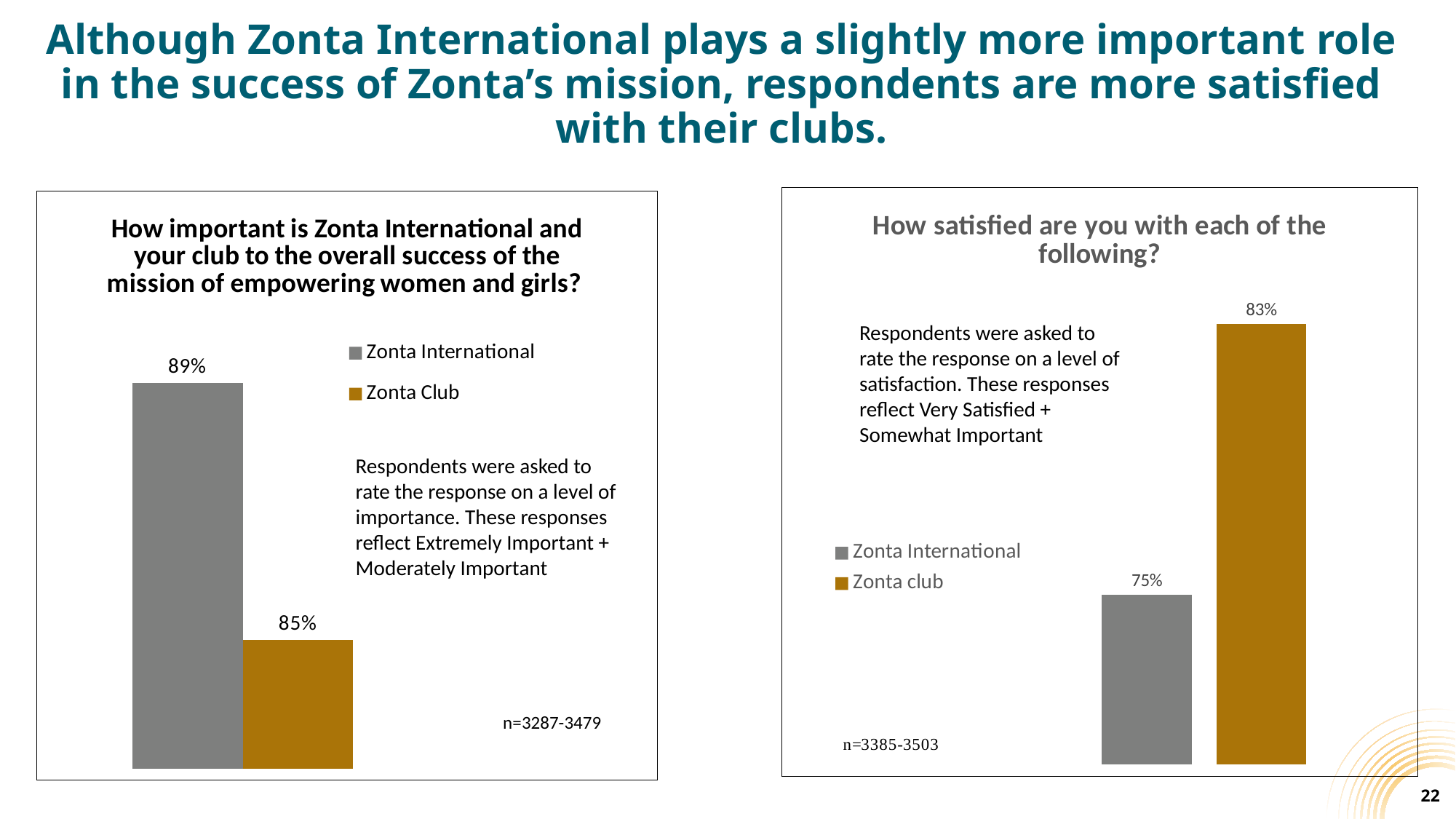
In the chart titled "How satisfied are you with each of the following?", what is the value for Zonta club? 83% How many series does the legend of the left chart list? 2 In the right chart, is the value for Zonta club larger or smaller than the value for Zonta International? larger In the right chart, what colour is the bar for Zonta club? gold What kind of chart is the chart on the right? bar chart In the chart titled "How important is Zonta International and your club to the overall success of the mission of empowering women and girls?", what is the value for Zonta Club? 85% In the left chart, what is the difference between the Zonta International and Zonta Club values? 4% In the left chart, which series has the higher value? Zonta International In the right chart, what is the difference between the Zonta club and Zonta International values? 8% In the chart titled "How important is Zonta International and your club to the overall success of the mission of empowering women and girls?", what is the value for Zonta International? 89% In the chart titled "How satisfied are you with each of the following?", what is the value for Zonta International? 75% In the right chart, which series has the lower value? Zonta International